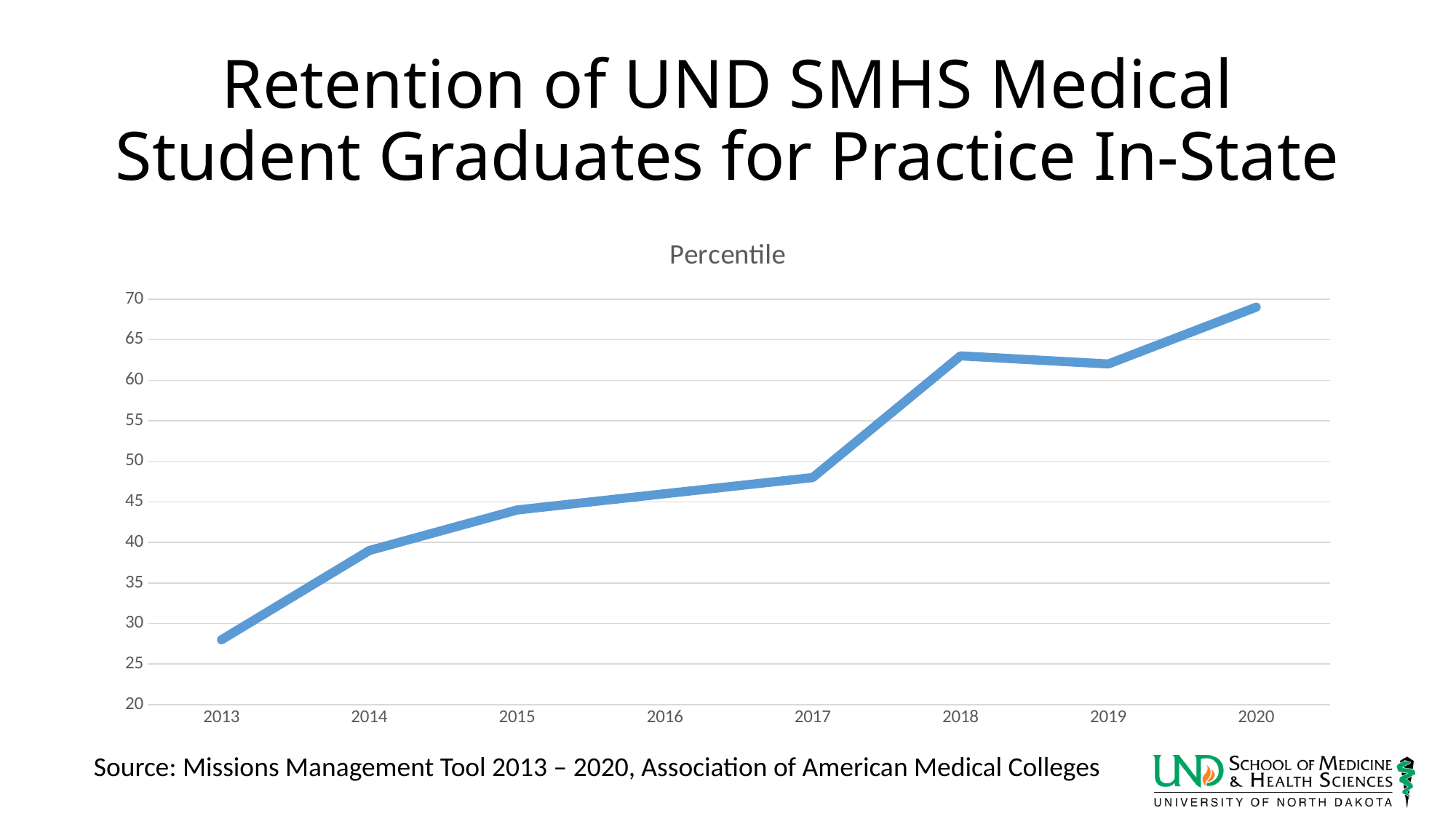
What is the title shown above the chart? Percentile Which is larger, the value for 2017 or the value for 2018? 2018 Is the value for 2017 greater or less than 50? less Is the value for 2013 greater or less than 30? less Is the value for 2020 greater or less than 65? greater Do the values generally rise or fall from 2013 to 2020? rise What kind of chart is shown on the slide? line chart Which year has the lowest value? 2013 How many years are plotted on the x axis? 8 Which year has the highest value? 2020